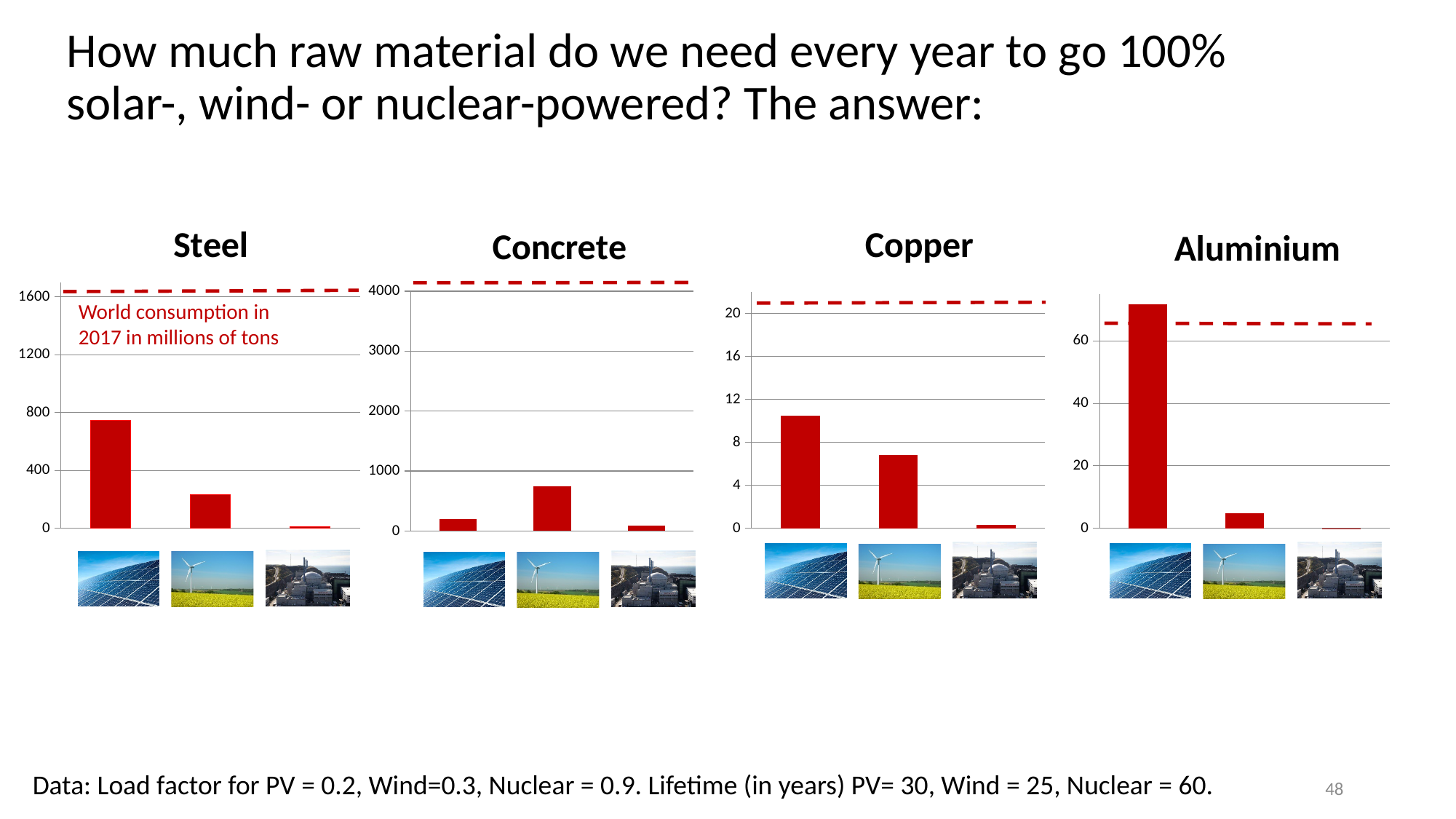
In the Aluminium chart, which is larger, the first (solar) bar or the second (wind) bar? the first (solar) bar In the Aluminium chart, is the value of the first (solar) bar greater or less than 60? greater In the Copper chart, which bar is the lowest: the first (solar), second (wind) or third (nuclear)? the third (nuclear) In the Concrete chart, is the value of the second (wind) bar greater or less than 1000? less In the Concrete chart, which bar is the highest: the first (solar), second (wind) or third (nuclear)? the second (wind) In the Steel chart, which bar is the highest: the first (solar), second (wind) or third (nuclear)? the first (solar) In the Steel chart, is the value of the first (solar) bar greater or less than 400? greater What kind of chart is the Steel chart? bar chart How many bars does the Copper chart contain? 3 According to the Steel chart, what does the red dashed line represent? World consumption in 2017 in millions of tons